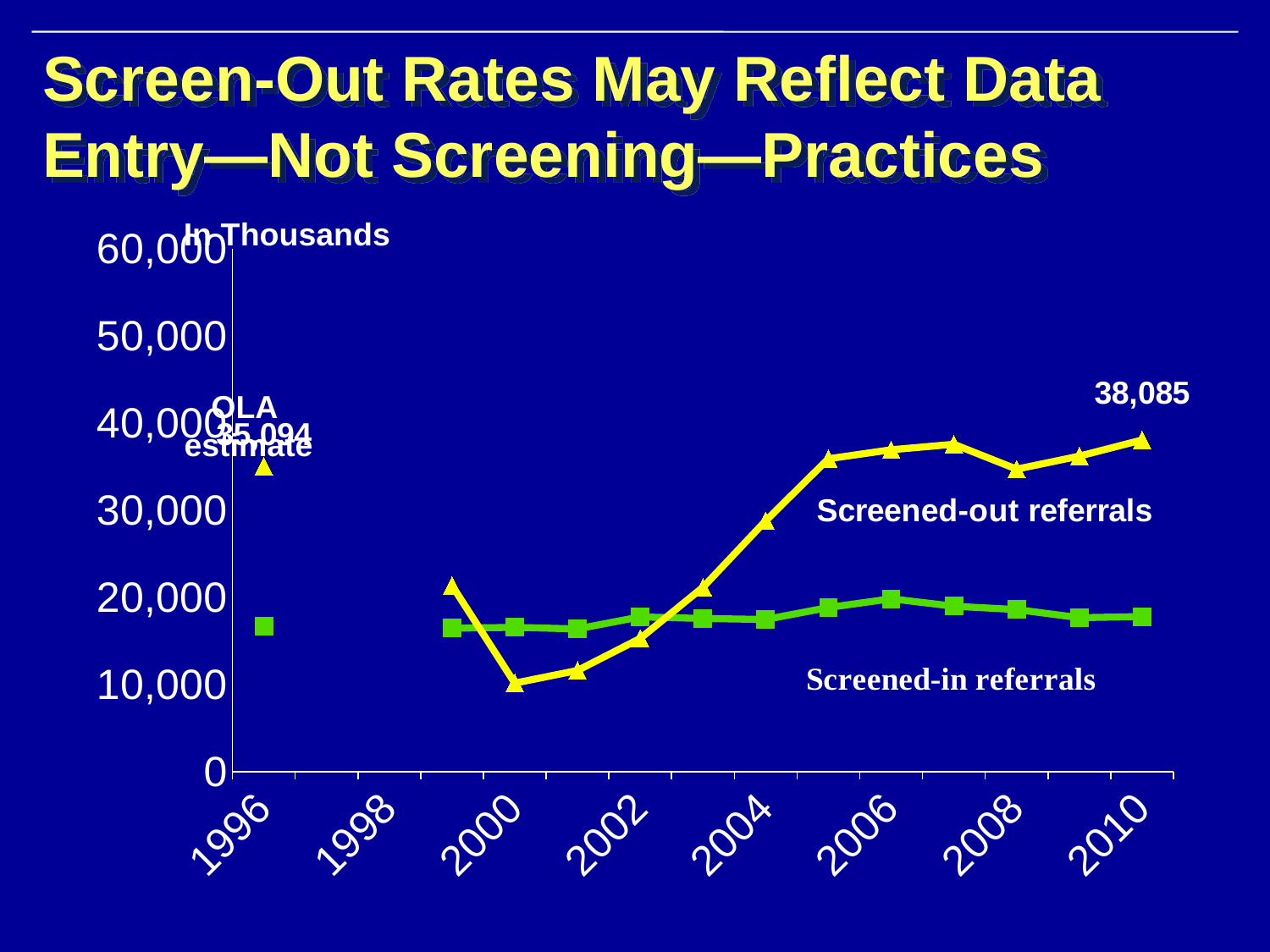
Is the value for screened-out referrals in 2008 greater or less than 40,000? less In 2010, which is larger: screened-out referrals or screened-in referrals? Screened-out referrals In 2000, which is larger: screened-out referrals or screened-in referrals? Screened-in referrals How many data series are plotted on the chart? 2 Do screened-out referrals rise or fall between 2000 and 2007? rise What type of chart is shown on the slide? line chart Is the value for screened-out referrals in 2005 greater or less than 30,000? greater In which year are screened-out referrals at their lowest? 2000 What unit label is shown at the top of the y axis? In Thousands Is the value for screened-in referrals in 1999 greater or less than 20,000? less What label is attached to the 1996 data point on the chart? OLA estimate What is the value of screened-out referrals in 2010? 38,085